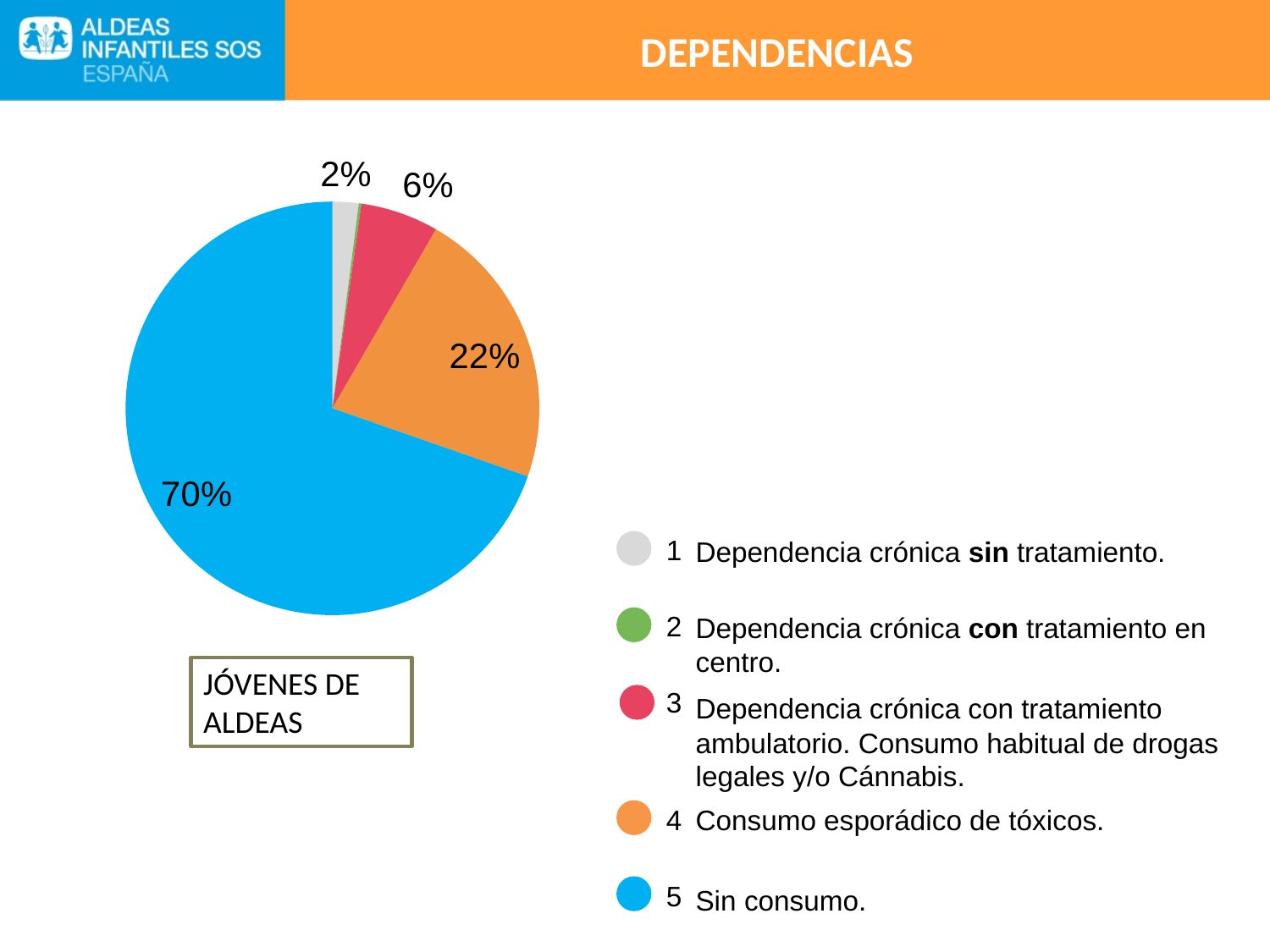
What is the title shown in the header of the slide? DEPENDENCIAS What is the difference in percentage points between "Sin consumo" and "Consumo esporádico de tóxicos"? 48 What percentage of the pie chart corresponds to "Sin consumo"? 70% Which is larger: the share for "Dependencia crónica sin tratamiento" or the share for "Dependencia crónica con tratamiento ambulatorio"? Dependencia crónica con tratamiento ambulatorio What percentage of the pie chart corresponds to "Dependencia crónica sin tratamiento"? 2% What type of chart is shown on the slide? Pie chart How many categories are listed in the legend of the chart? 5 What percentage of the pie chart corresponds to "Dependencia crónica con tratamiento ambulatorio"? 6% Which category has the largest share of the pie chart? Sin consumo What colour is the slice representing "Sin consumo"? Blue What is the difference in percentage points between "Consumo esporádico de tóxicos" and "Dependencia crónica con tratamiento ambulatorio"? 16 What percentage of the pie chart corresponds to "Consumo esporádico de tóxicos"? 22%